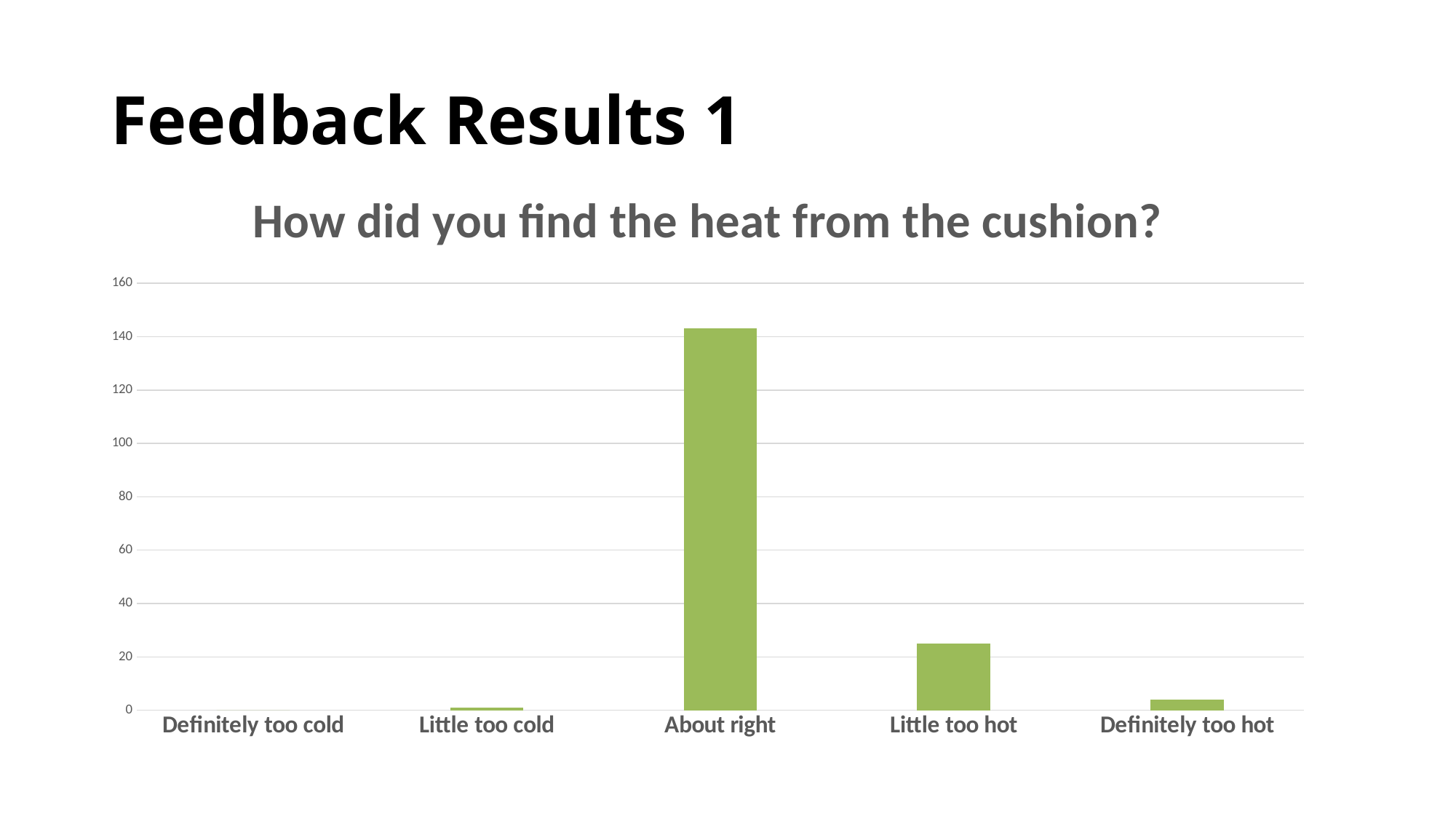
What is the highest value shown on the y axis? 160 Is the value for About right greater or less than 120? greater Is the value for Definitely too hot greater or less than 20? less Is the value for Little too hot greater or less than 20? greater Which is larger, the value for Little too hot or the value for Definitely too hot? Little too hot What is the title of the chart? How did you find the heat from the cushion? Which is larger, the value for About right or the value for Little too hot? About right What kind of chart is shown on the slide? bar chart Which category has the highest value? About right How many categories are shown on the x axis of the chart? 5